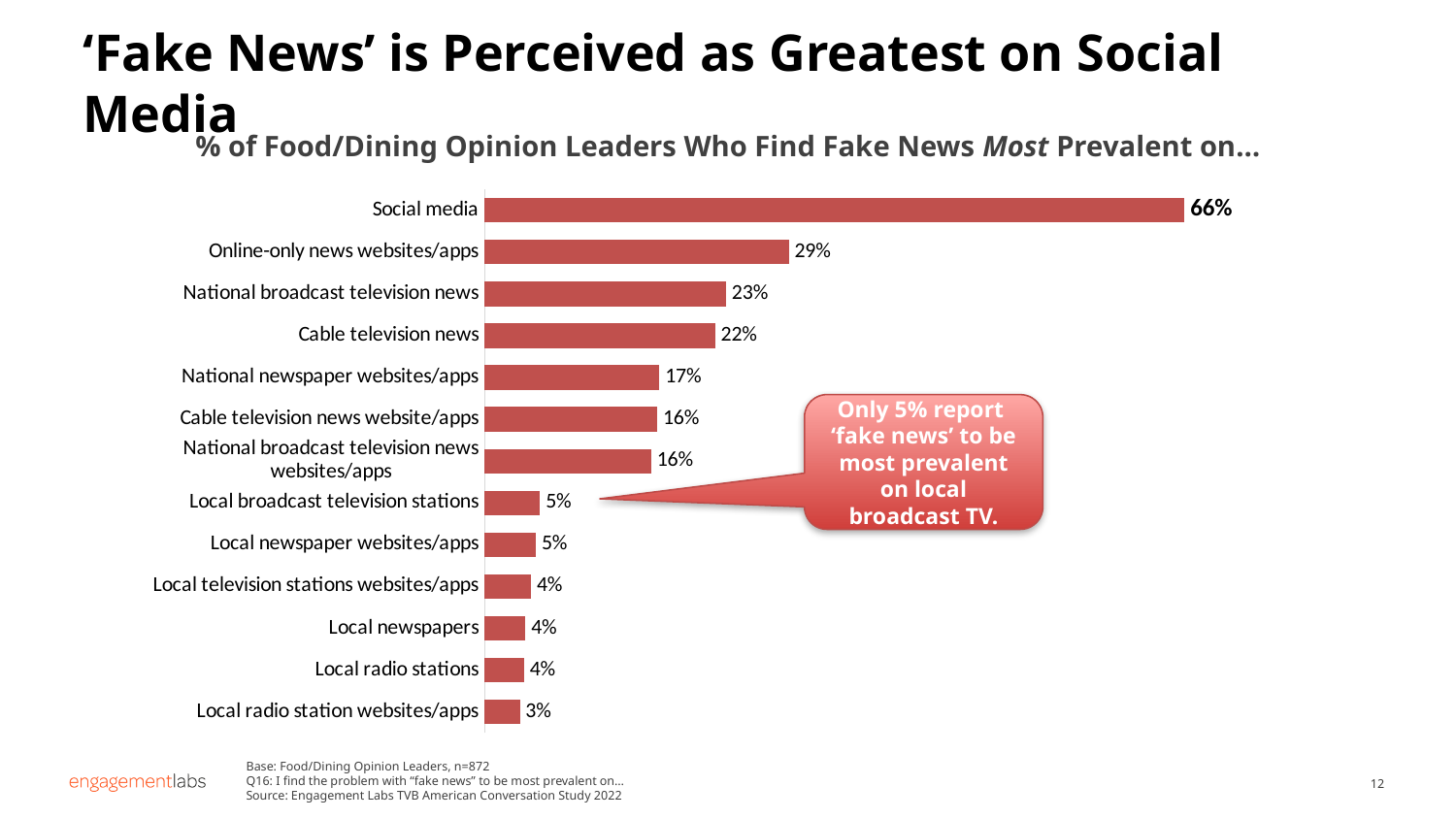
How many categories are shown in the chart? 13 What is the value for Local broadcast television stations? 5% Which is larger: National broadcast television news or Cable television news? National broadcast television news What is the difference between the values for Social media and Online-only news websites/apps? 37% What percentage of Food/Dining Opinion Leaders find fake news most prevalent on social media? 66% Which category has the highest value? Social media What is the title of the chart? % of Food/Dining Opinion Leaders Who Find Fake News Most Prevalent on… What is the difference between the values for National newspaper websites/apps and Local newspapers? 13% What kind of chart is shown on the slide? Bar chart Which category has the lowest value? Local radio station websites/apps What is the value for Cable television news? 22% What is the value for Online-only news websites/apps? 29%